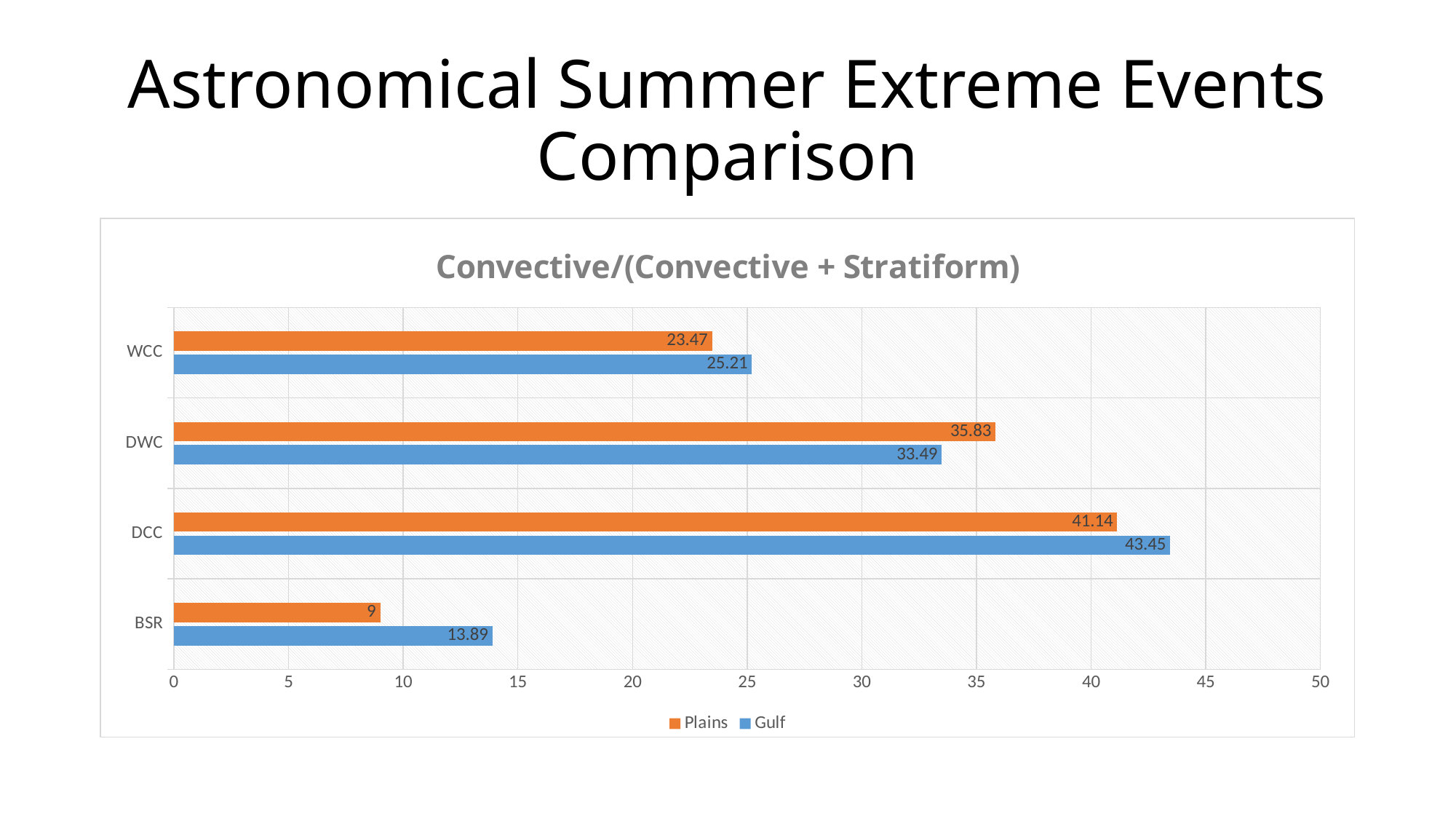
How many categories are shown on the chart? 4 What is the Plains value for DCC? 41.14 For DWC, which is larger, the Plains value or the Gulf value? Plains What is the difference between the Gulf and Plains values for BSR? 4.89 What is the difference between the Plains and Gulf values for DWC? 2.34 What type of chart is shown? Bar chart How many series does the legend list? 2 What is the Gulf value for WCC? 25.21 What is the Gulf value for BSR? 13.89 Which category has the highest Gulf value? DCC Which category has the lowest Plains value? BSR Is the Gulf value for DCC greater or less than 40? greater